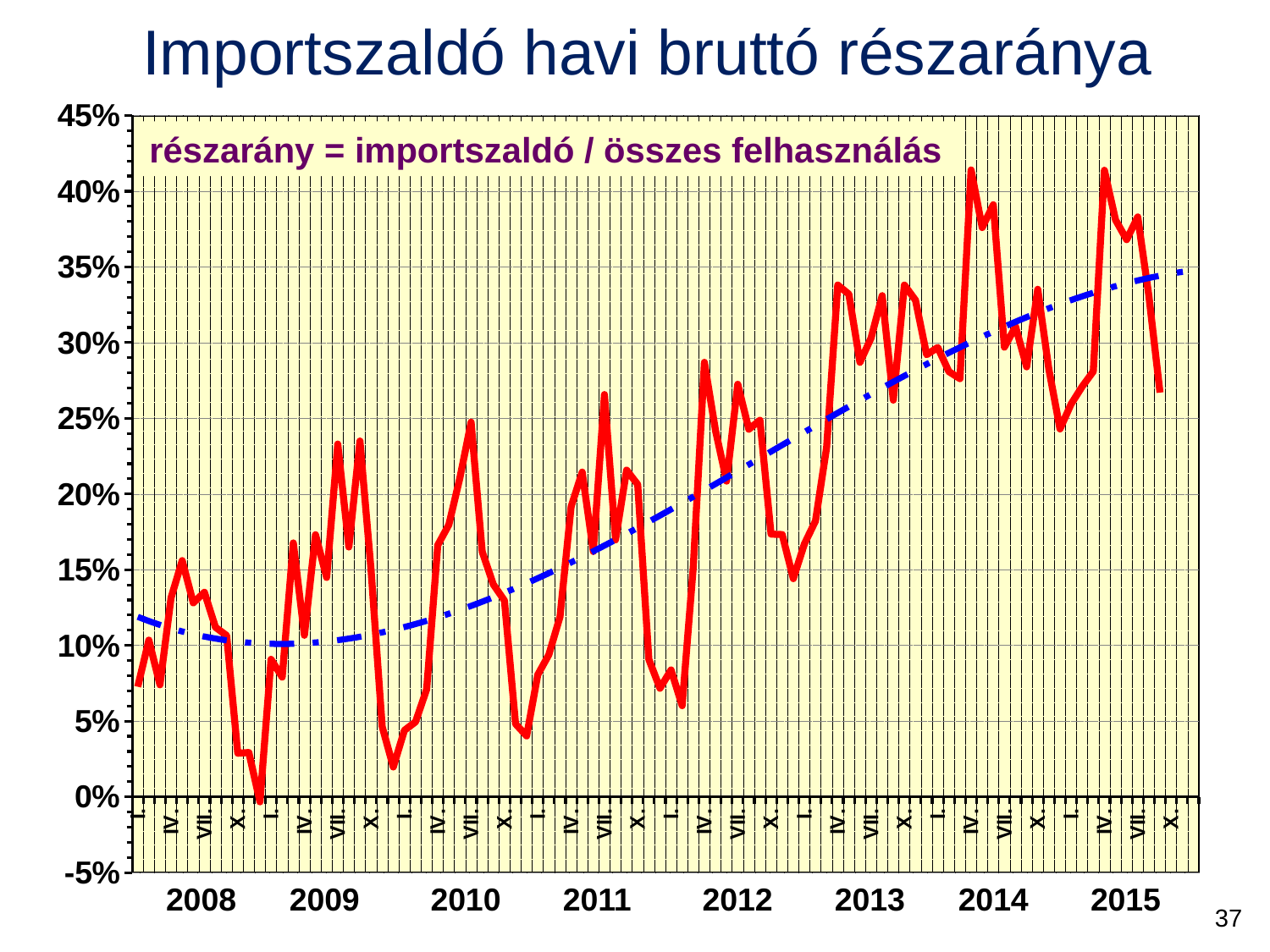
Is the peak of the red line in 2010 greater or less than 20%? greater Is the highest value of the red line in 2013 greater or less than 40%? less Is the value of the blue dashed trend line at the end of 2015 greater or less than 30%? greater In which year does the red line reach its lowest point? 2008 How many years are labelled along the x axis? 8 What is the title of the chart? Importszaldó havi bruttó részaránya What formula is written inside the chart area? részarány = importszaldó / összes felhasználás Does the blue dashed trend line generally rise or fall from 2008 to 2015? rise What kind of chart is shown on the slide? line chart Which is higher: the peak of the red line in 2009 or the peak of the red line in 2013? 2013